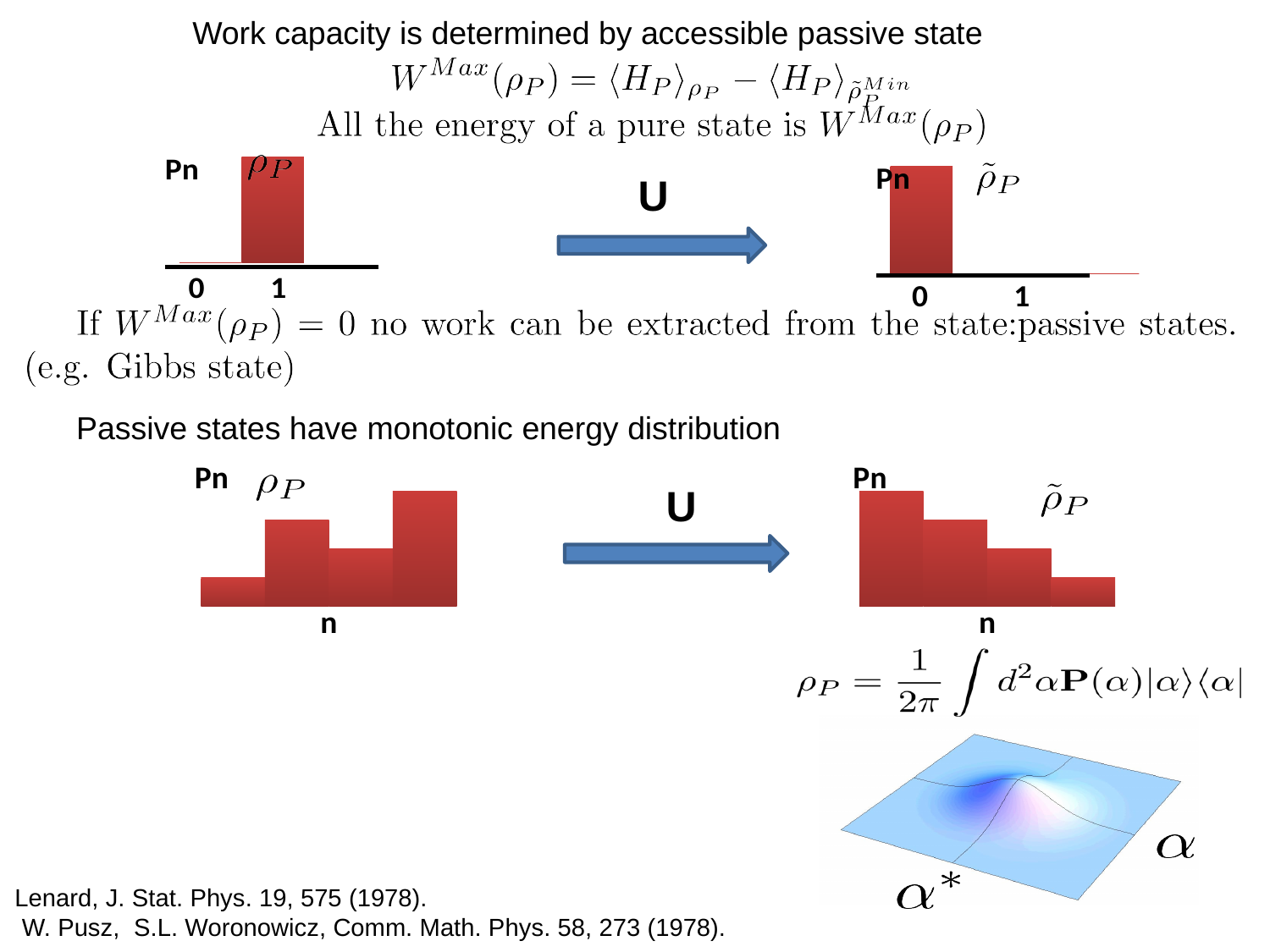
What label is written at the top-left of each bar chart to denote the vertical quantity? Pn In the bottom-right chart labelled ρ̃_P, do the bar heights rise or fall from left to right along the n axis? fall What kind of chart is the top-left chart labelled ρ_P? bar chart What label is written on the horizontal axis of the bottom-left chart labelled ρ_P? n How many bars are in the bottom-left chart labelled ρ_P? 4 In the bottom-left chart labelled ρ_P, which bar is the tallest: the first, second, third or fourth from the left? fourth In the top-right chart labelled ρ̃_P, which x-axis category, 0 or 1, has the taller bar? 0 How many bars are in the bottom-right chart labelled ρ̃_P? 4 In the top-left chart labelled ρ_P, which x-axis category, 0 or 1, has the taller bar? 1 In the bottom-left chart labelled ρ_P, which bar is the shortest: the first, second, third or fourth from the left? first How many x-axis tick labels are shown on the top-left chart labelled ρ_P? 2 In the bottom-left chart labelled ρ_P, is the second bar from the left taller or shorter than the third bar? taller